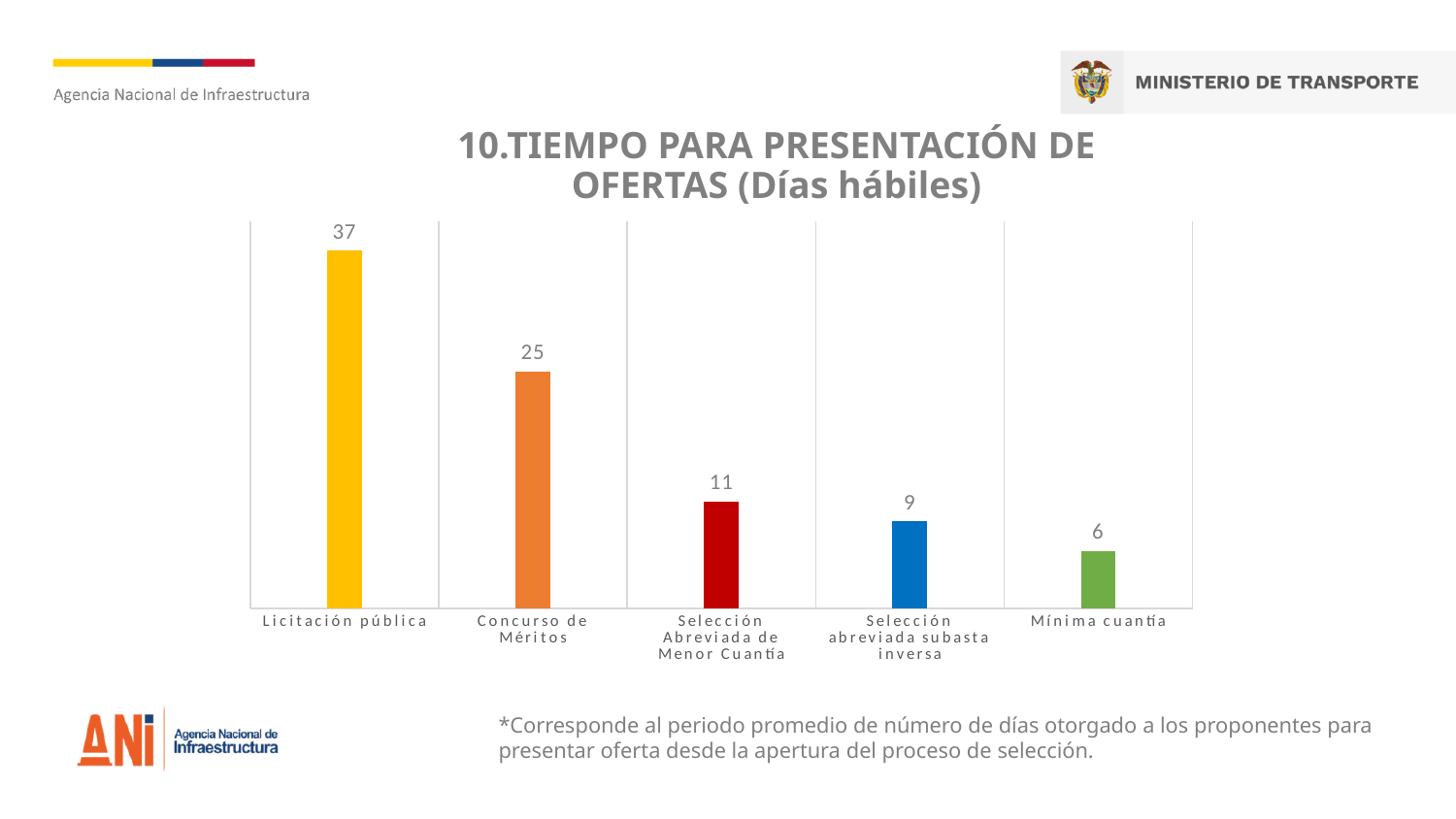
Do the values rise or fall from left to right across the categories? Fall What is the value for Licitación pública? 37 What is the value for Selección abreviada subasta inversa? 9 What is the value for Concurso de Méritos? 25 Which is larger, the value for Selección Abreviada de Menor Cuantía or the value for Selección abreviada subasta inversa? Selección Abreviada de Menor Cuantía What is the difference between the values for Licitación pública and Concurso de Méritos? 12 How many categories are shown in the chart? 5 What is the value for Mínima cuantía? 6 What kind of chart is shown on the slide? Bar chart What is the value for Selección Abreviada de Menor Cuantía? 11 Which category has the lowest value? Mínima cuantía Which category has the highest value? Licitación pública